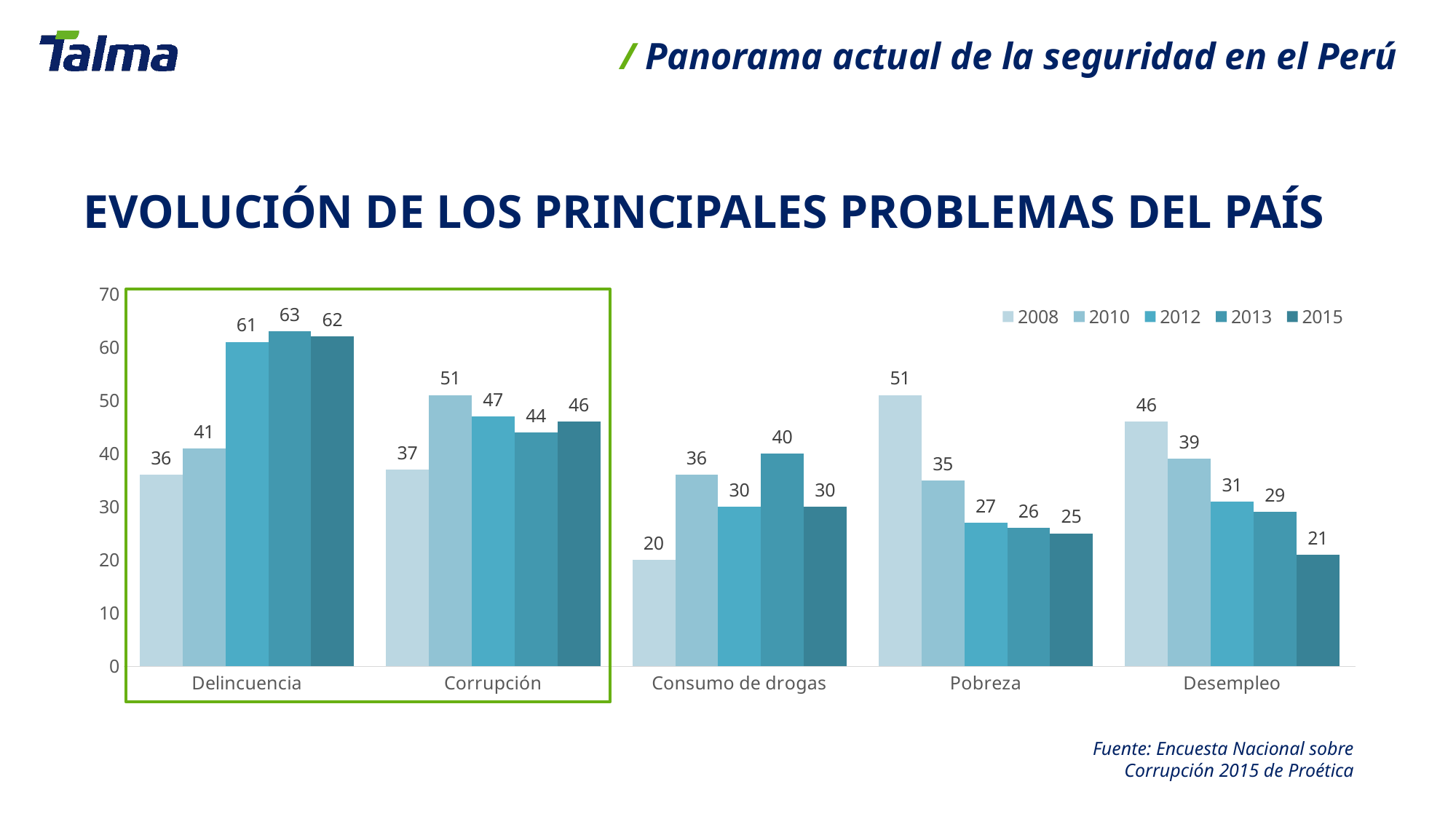
What is the difference between the 2015 and 2008 values for Delincuencia? 26 What kind of chart is shown on the slide? Bar chart Which is larger, the 2010 value for Corrupción or the 2010 value for Pobreza? Corrupción What is the value for Delincuencia in 2013? 63 How many categories are shown on the x axis? 5 How many series does the legend list? 5 Which category has the highest value in 2015? Delincuencia What is the value for Consumo de drogas in 2008? 20 Do the values for Pobreza rise or fall from 2008 to 2015? Fall What is the value for Desempleo in 2015? 21 Which two categories are enclosed by the green box? Delincuencia and Corrupción Which category has the lowest value in 2008? Consumo de drogas